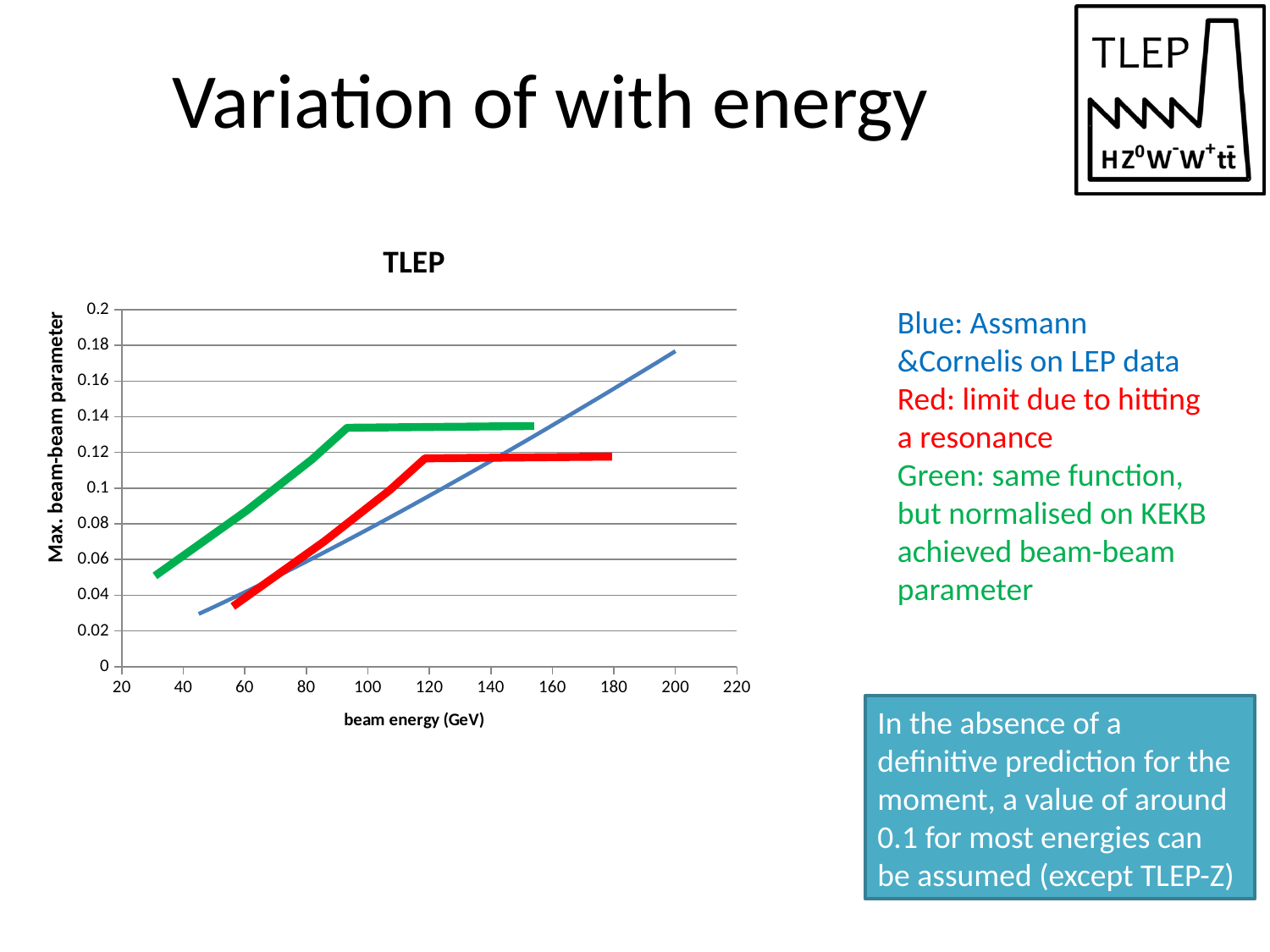
Is the value of the blue line at a beam energy of 100 GeV greater or less than 0.1? less What is the label of the vertical axis of the chart? Max. beam-beam parameter At a beam energy of 180 GeV, which line has the higher value, the blue line or the red line? blue line Is the value of the red line at a beam energy of 160 GeV greater or less than 0.1? greater What is the title of the chart? TLEP How many lines are plotted on the chart? 3 Is the value of the blue line at a beam energy of 200 GeV greater or less than 0.16? greater Which line reaches the highest value on the chart? blue line Does the blue line rise or fall as beam energy increases? rises What kind of chart is shown on the slide? line chart At a beam energy of 100 GeV, which line has the higher value, the green line or the blue line? green line